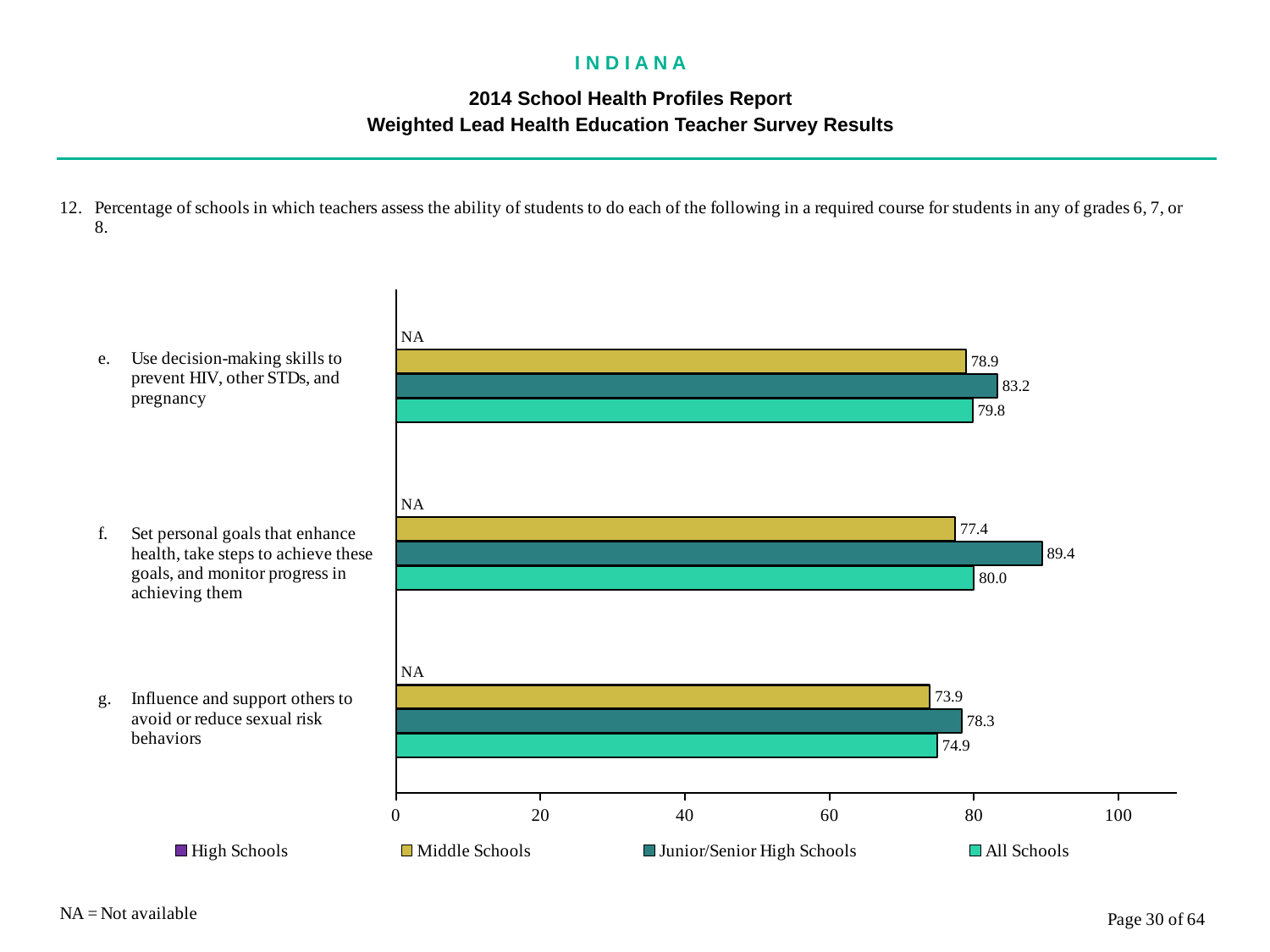
What value is shown for High Schools for item e? NA What is the value for Middle Schools for item e, 'Use decision-making skills to prevent HIV, other STDs, and pregnancy'? 78.9 For item g, which is larger: the Junior/Senior High Schools value or the All Schools value? Junior/Senior High Schools What is the difference between the Junior/Senior High Schools and Middle Schools values for item f? 12.0 How many series does the legend list? 4 What kind of chart is shown on the slide? bar chart Is the All Schools value for item e greater or less than 60? greater Which item has the lowest Middle Schools value? g. Influence and support others to avoid or reduce sexual risk behaviors What is the value for All Schools for item g, 'Influence and support others to avoid or reduce sexual risk behaviors'? 74.9 How many items (categories) are plotted on the chart? 3 What is the value for Junior/Senior High Schools for item f, 'Set personal goals that enhance health...'? 89.4 Which item has the highest Junior/Senior High Schools value? f. Set personal goals that enhance health, take steps to achieve these goals, and monitor progress in achieving them